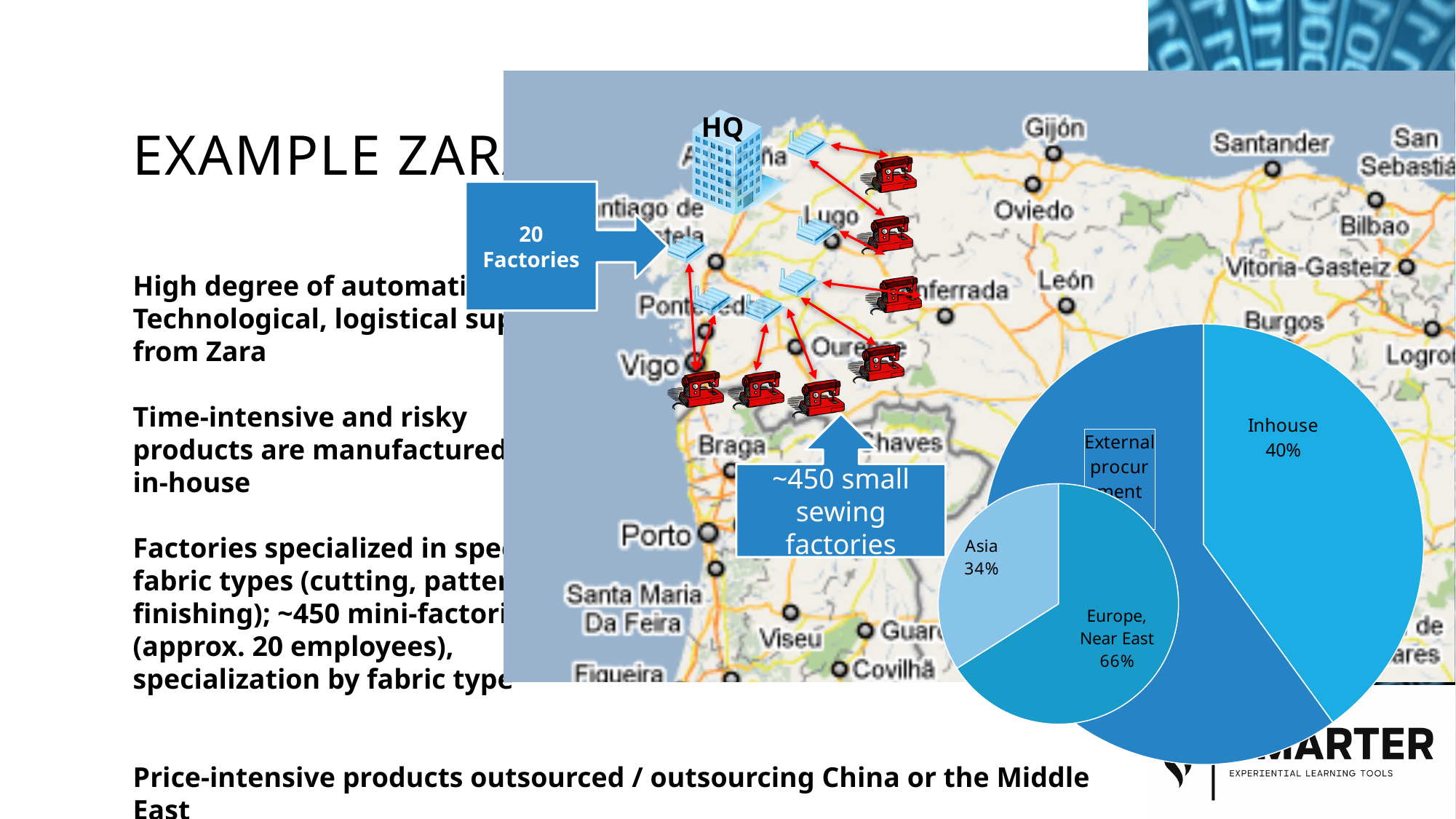
In the smaller pie chart, what share is labelled for Europe, Near East? 66% In the smaller pie chart, which slice is larger, Asia or Europe, Near East? Europe, Near East How many slices does the larger pie chart have? 2 What kind of chart is used to show the Inhouse versus External procurement split? Pie chart In the smaller pie chart, which slice is the smallest? Asia In the larger pie chart, which slice is the smallest? Inhouse In the larger pie chart, which slice is larger, Inhouse or External procurement? External procurement In the smaller pie chart, what share is labelled for Asia? 34% In the smaller pie chart, by how many percentage points does Europe, Near East exceed Asia? 32 percentage points In the larger pie chart, what share is labelled for Inhouse? 40% How many pie charts are shown on the slide? 2 How many slices does the smaller pie chart have? 2